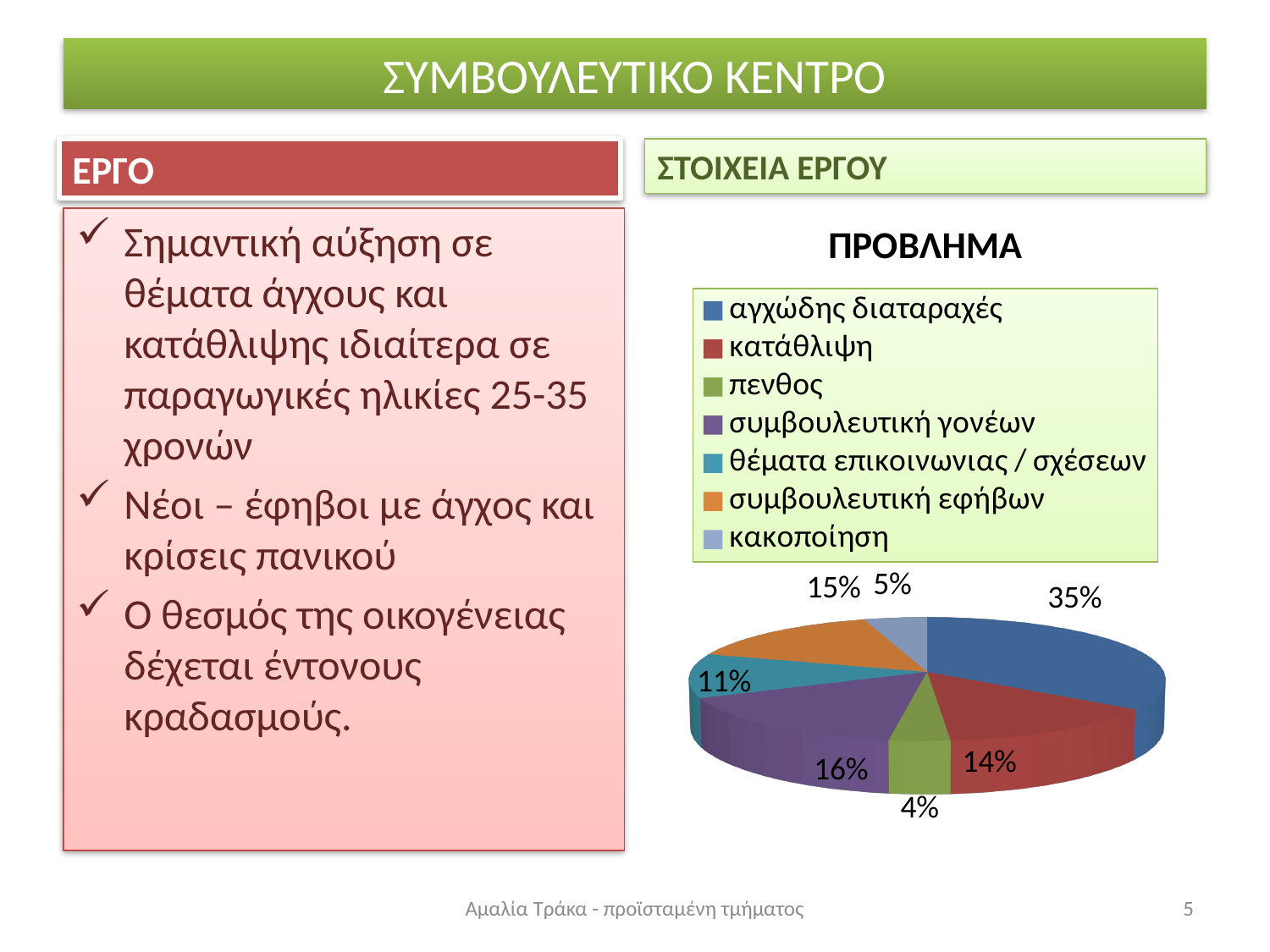
What is the difference in percentage points between αγχώδης διαταραχές and κατάθλιψη? 21 What is the title of the chart on the slide? ΠΡΟΒΛΗΜΑ How many categories does the legend of the pie chart list? 7 What colour is the slice for συμβουλευτική εφήβων in the pie chart? orange What percentage of the pie chart is κατάθλιψη? 14% What percentage of the pie chart is αγχώδης διαταραχές? 35% Which category has the smallest share of the pie chart? πενθος What percentage of the pie chart is κακοποίηση? 5% What percentage of the pie chart is συμβουλευτική γονέων? 16% Which category has the largest share of the pie chart? αγχώδης διαταραχές Which has a larger share of the pie chart, συμβουλευτική εφήβων or θέματα επικοινωνιας / σχέσεων? συμβουλευτική εφήβων What kind of chart is shown under the title ΠΡΟΒΛΗΜΑ? pie chart